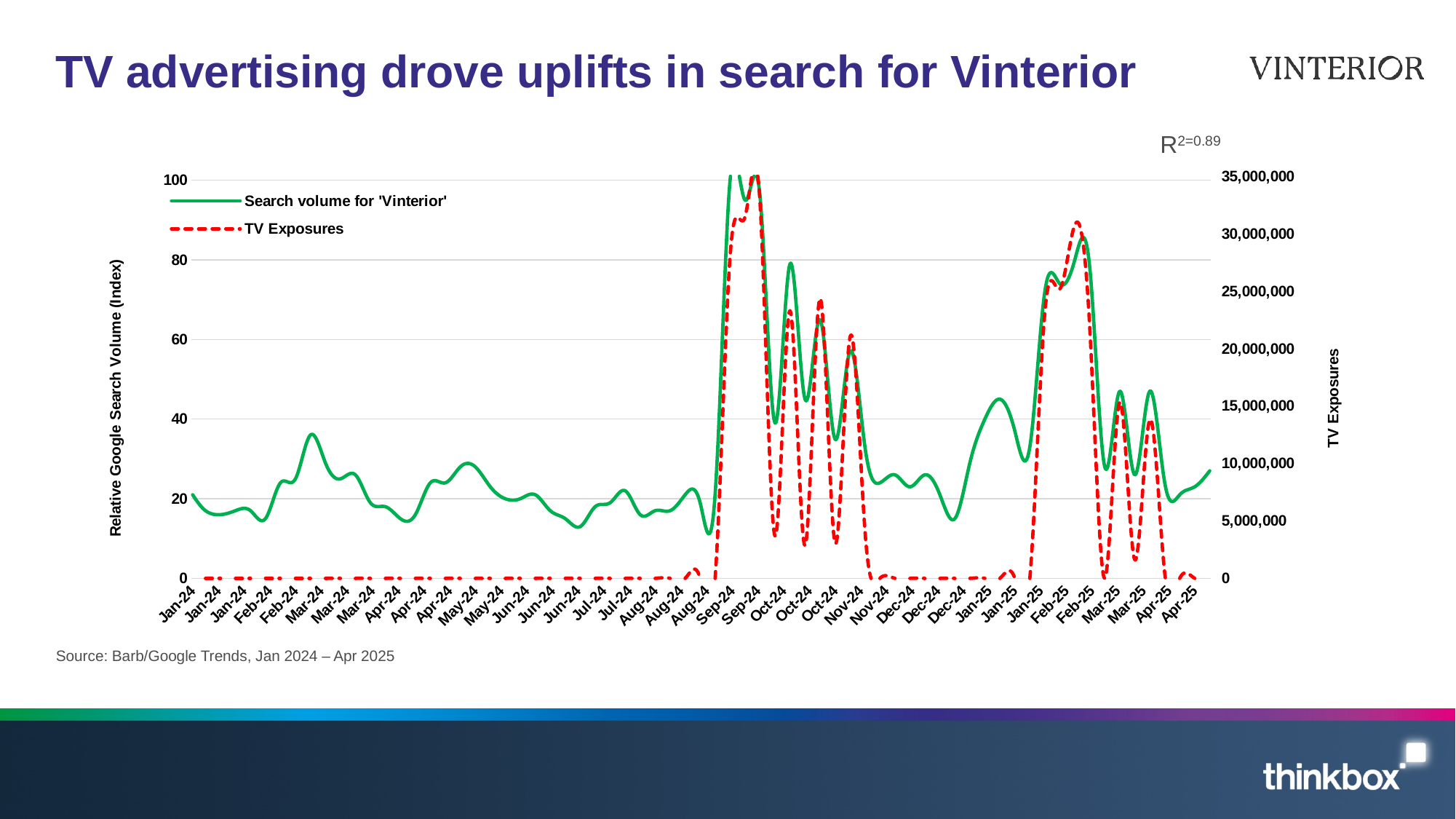
What kind of chart is shown on the slide? Line chart In which month does the search volume for 'Vinterior' reach its highest point? Sep-24 What are the two series named in the chart legend? Search volume for 'Vinterior' and TV Exposures Is the peak search volume for 'Vinterior' in Mar-24 greater or less than 40? less Is the search volume for 'Vinterior' in Dec-24 greater or less than 40? less Is the peak of TV Exposures in Feb-25 greater or less than 25,000,000? greater What is the title of the slide containing the chart? TV advertising drove uplifts in search for Vinterior How many series does the chart legend list? 2 What is the maximum value shown on the right-hand TV Exposures axis? 35,000,000 What R-squared value is printed on the chart? 0.89 What is the maximum value shown on the left-hand Relative Google Search Volume axis? 100 How does the search volume for 'Vinterior' change from Aug-24 to Sep-24? It rises sharply